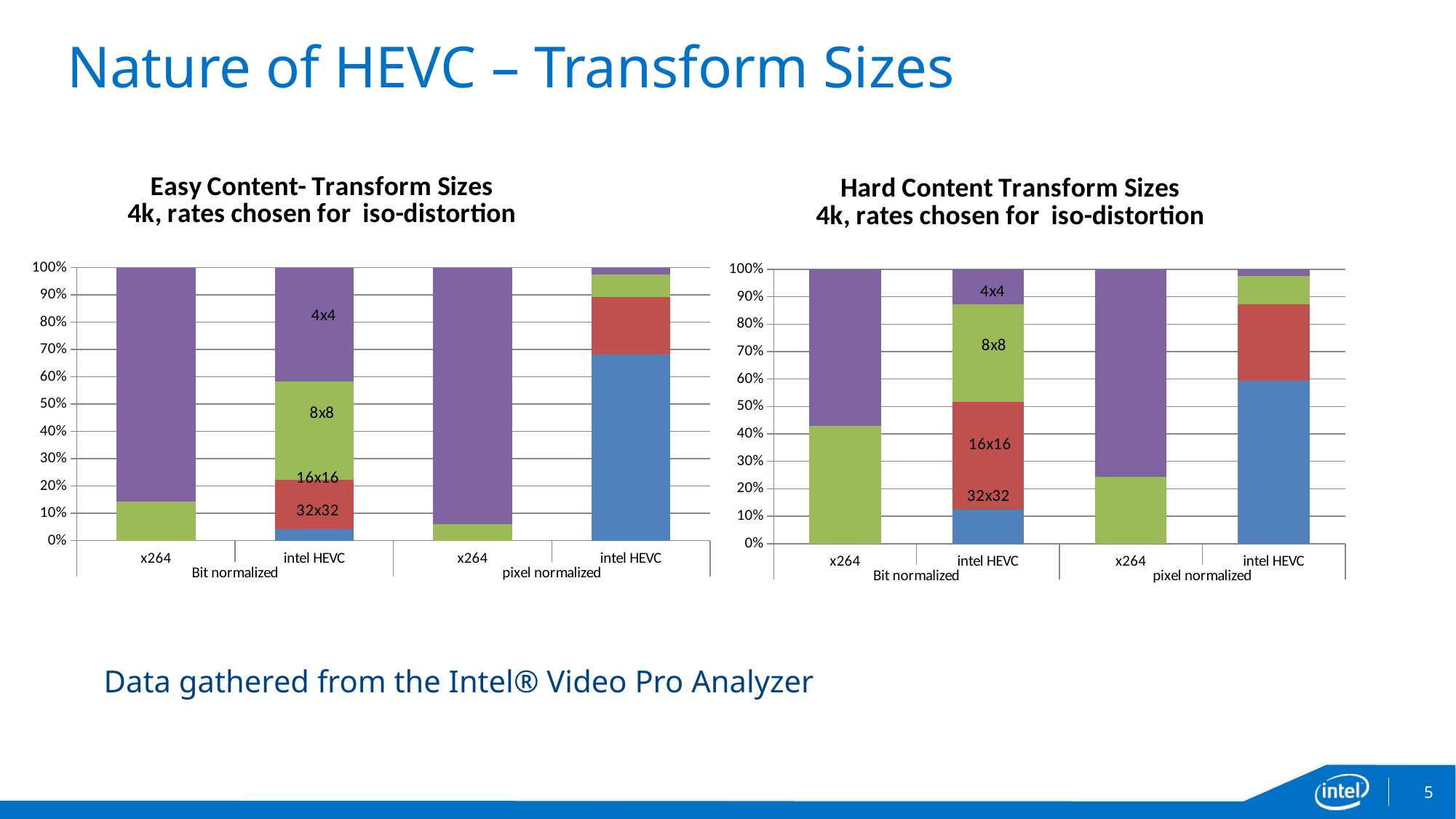
In the Easy Content- Transform Sizes chart, is the 32x32 (blue) segment for intel HEVC under Bit normalized greater or less than 10%? less What is the second line of the title of the left chart? 4k, rates chosen for iso-distortion In the Hard Content Transform Sizes chart, is the 8x8 (green) segment for x264 under Bit normalized greater or less than 30%? greater In the Easy Content- Transform Sizes chart, is the top of the 8x8 (green) segment for x264 under Bit normalized greater or less than 20%? less In the Hard Content Transform Sizes chart, which x264 bar has the larger 8x8 (green) share: Bit normalized or pixel normalized? Bit normalized In the Easy Content- Transform Sizes chart, which intel HEVC bar has the larger 32x32 (blue) share: Bit normalized or pixel normalized? pixel normalized What kind of chart is the Easy Content- Transform Sizes chart? bar chart How many bars are plotted in the Hard Content Transform Sizes chart? 4 Which transform size is labelled on the topmost (purple) segment of the intel HEVC Bit normalized bar in the Hard Content Transform Sizes chart? 4x4